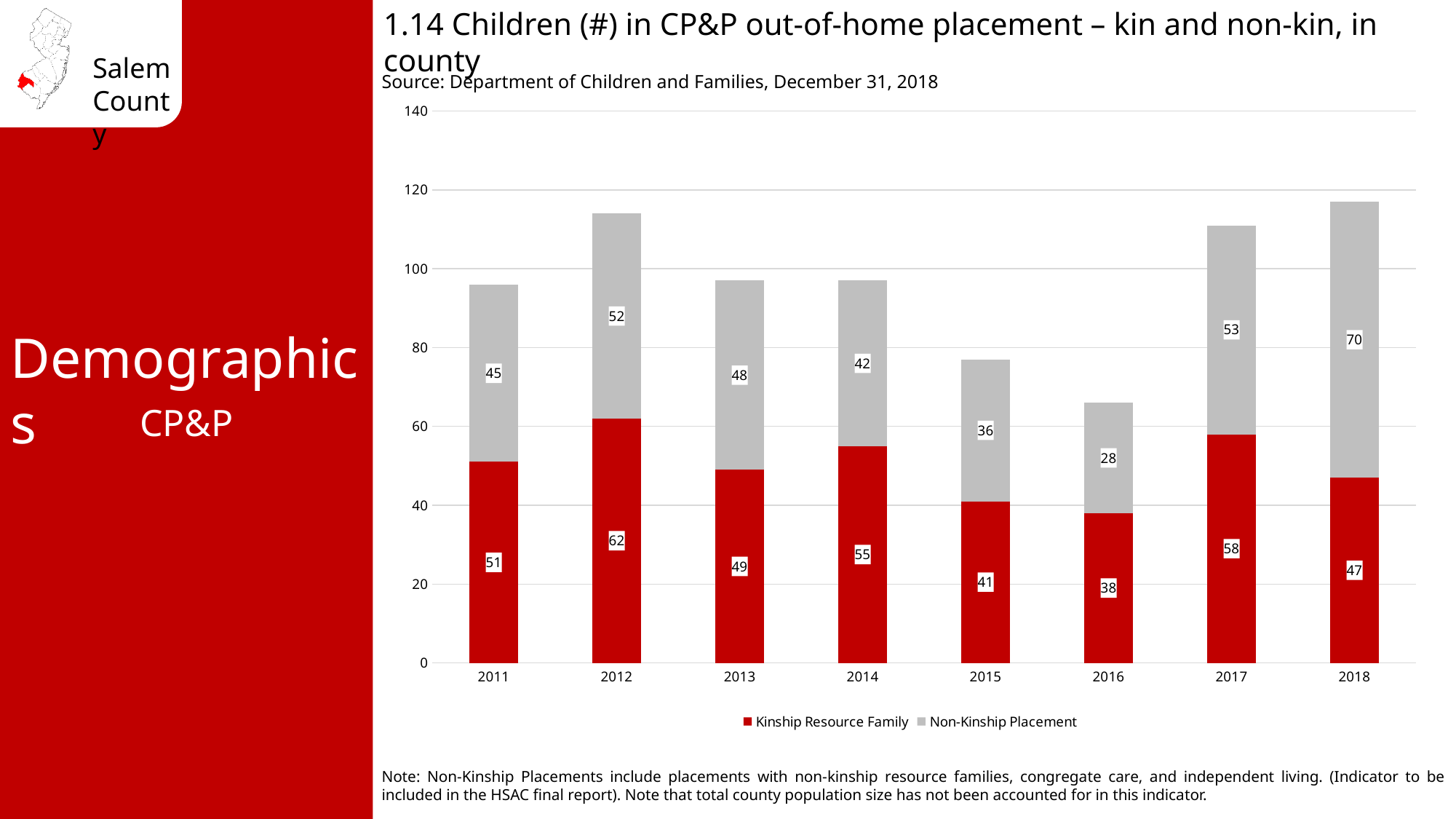
Which is larger, the Non-Kinship Placement value for 2012 or for 2014? 2012 What kind of chart is shown on the slide? Stacked bar chart How many years are shown on the x axis? 8 What is the difference between the Kinship Resource Family values for 2017 and 2015? 17 How many series does the legend list? 2 What is the Kinship Resource Family value for 2012? 62 What is the Kinship Resource Family value for 2016? 38 Which year has the highest Non-Kinship Placement value? 2018 What is the total of the stacked bar for 2016? 66 What is the Non-Kinship Placement value for 2018? 70 What is the total of the stacked bar for 2018? 117 Which year has the lowest Kinship Resource Family value? 2016